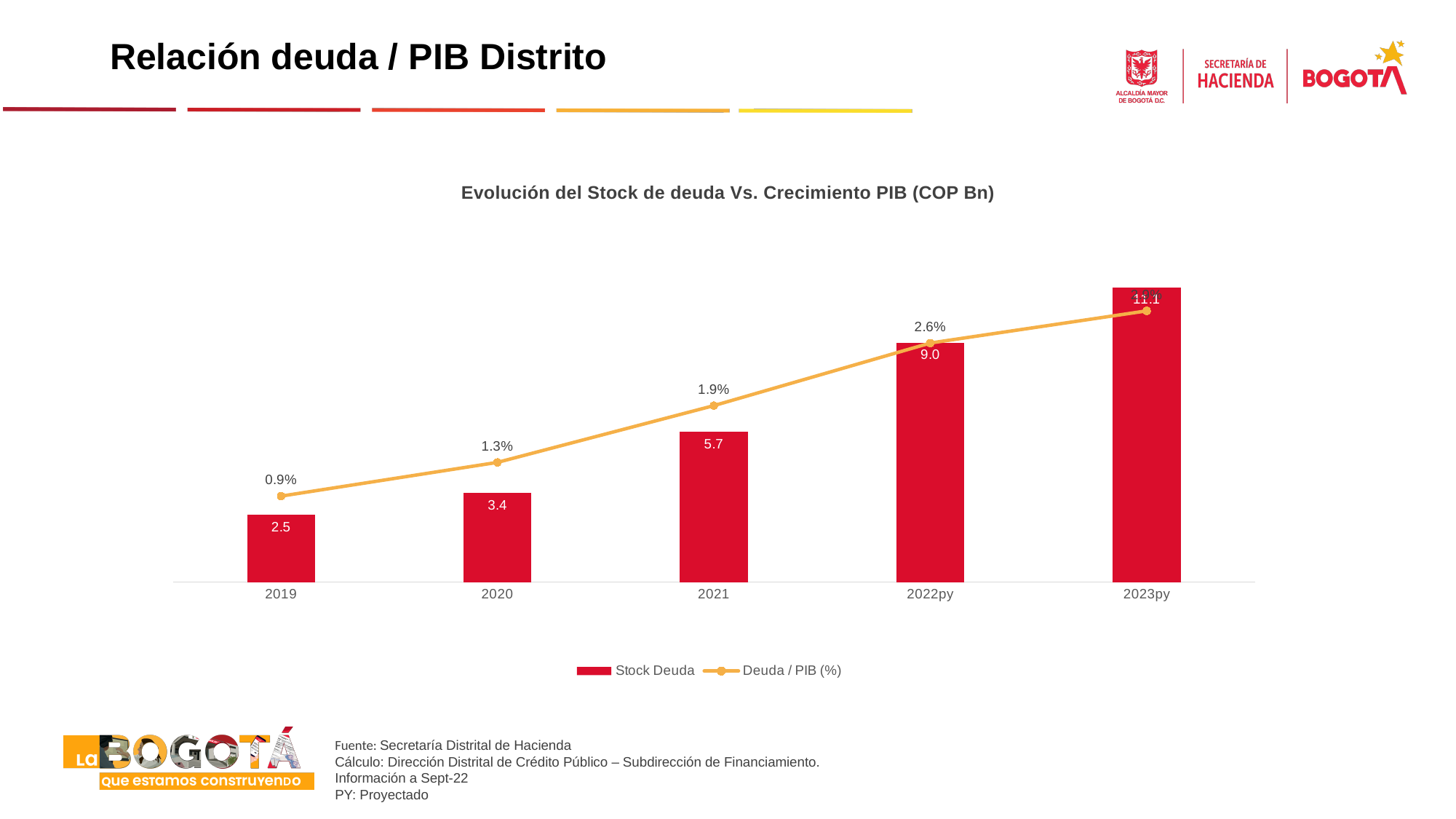
Which year has the lowest Deuda / PIB (%)? 2019 How many years are shown on the x axis? 5 Does the Stock Deuda rise or fall from 2019 to 2023py? rise What is the Stock Deuda value for 2019? 2.5 What is the Stock Deuda value for 2021? 5.7 What is the Deuda / PIB (%) value for 2022py? 2.6% What is the Stock Deuda value for 2022py? 9.0 What is the difference in Stock Deuda between 2022py and 2021? 3.3 What is the Deuda / PIB (%) value for 2020? 1.3% Which year has the highest Stock Deuda? 2023py How many series does the legend list? 2 Which is larger, the Stock Deuda for 2020 or for 2021? 2021